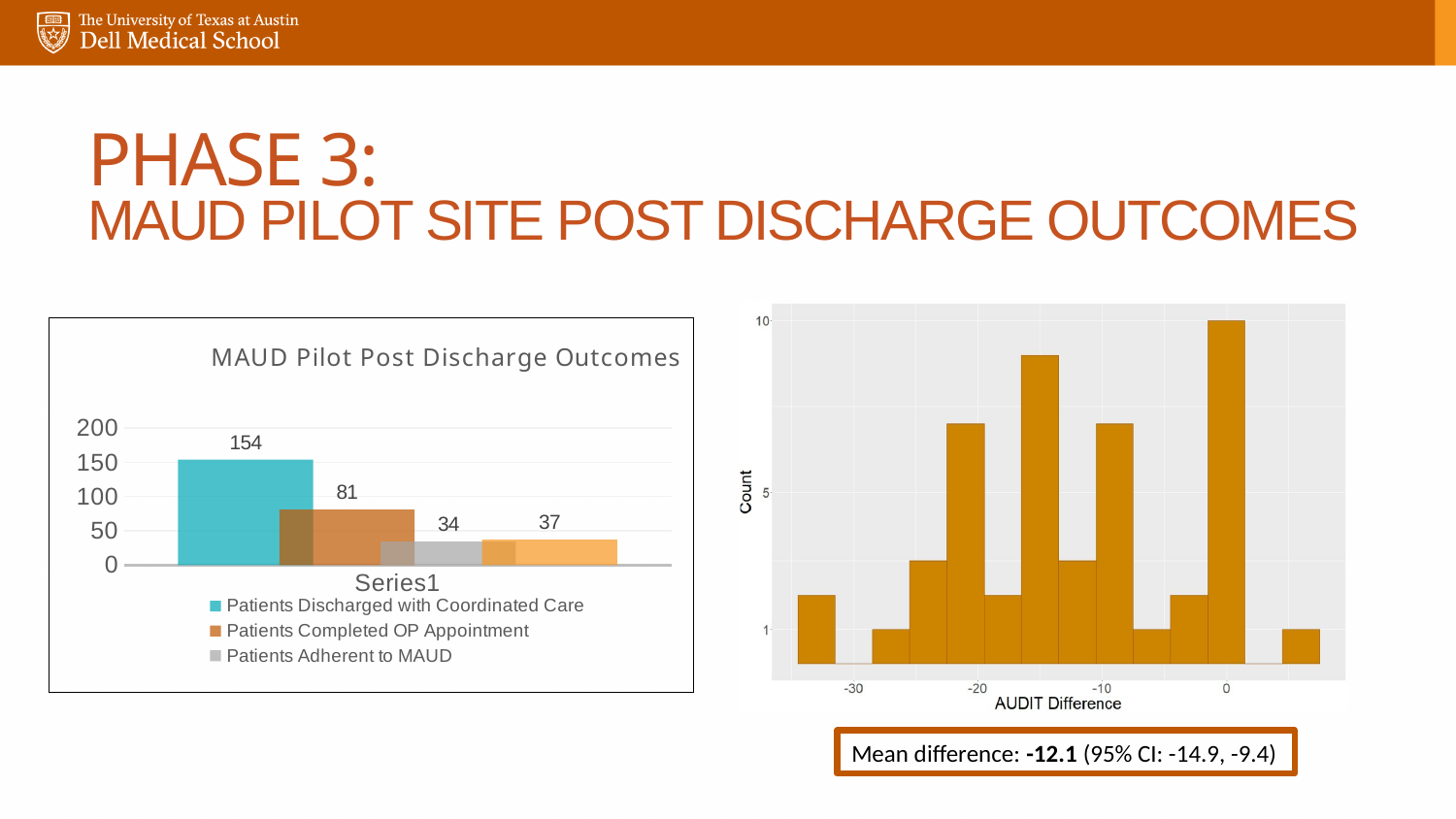
In the MAUD Pilot Post Discharge Outcomes chart, which is larger: Patients Completed OP Appointment or Patients Adherent to MAUD? Patients Completed OP Appointment In the MAUD Pilot Post Discharge Outcomes chart, is the value for Patients Discharged with Coordinated Care greater or less than 150? greater What mean difference is reported below the chart on the right? -12.1 How many entries does the legend of the MAUD Pilot Post Discharge Outcomes chart list? 3 In the MAUD Pilot Post Discharge Outcomes chart, which legend category has the highest value? Patients Discharged with Coordinated Care In the MAUD Pilot Post Discharge Outcomes chart, what is the difference between Patients Discharged with Coordinated Care and Patients Completed OP Appointment? 73 In the MAUD Pilot Post Discharge Outcomes chart, what is the value for Patients Completed OP Appointment? 81 In the chart on the right, what is the label of the x axis? AUDIT Difference In the MAUD Pilot Post Discharge Outcomes chart, what is the value for Patients Adherent to MAUD? 34 In the MAUD Pilot Post Discharge Outcomes chart, what is the value for Patients Discharged with Coordinated Care? 154 What kind of chart is the MAUD Pilot Post Discharge Outcomes chart on the left? bar chart In the chart on the right, what count does the tallest bar reach? 10